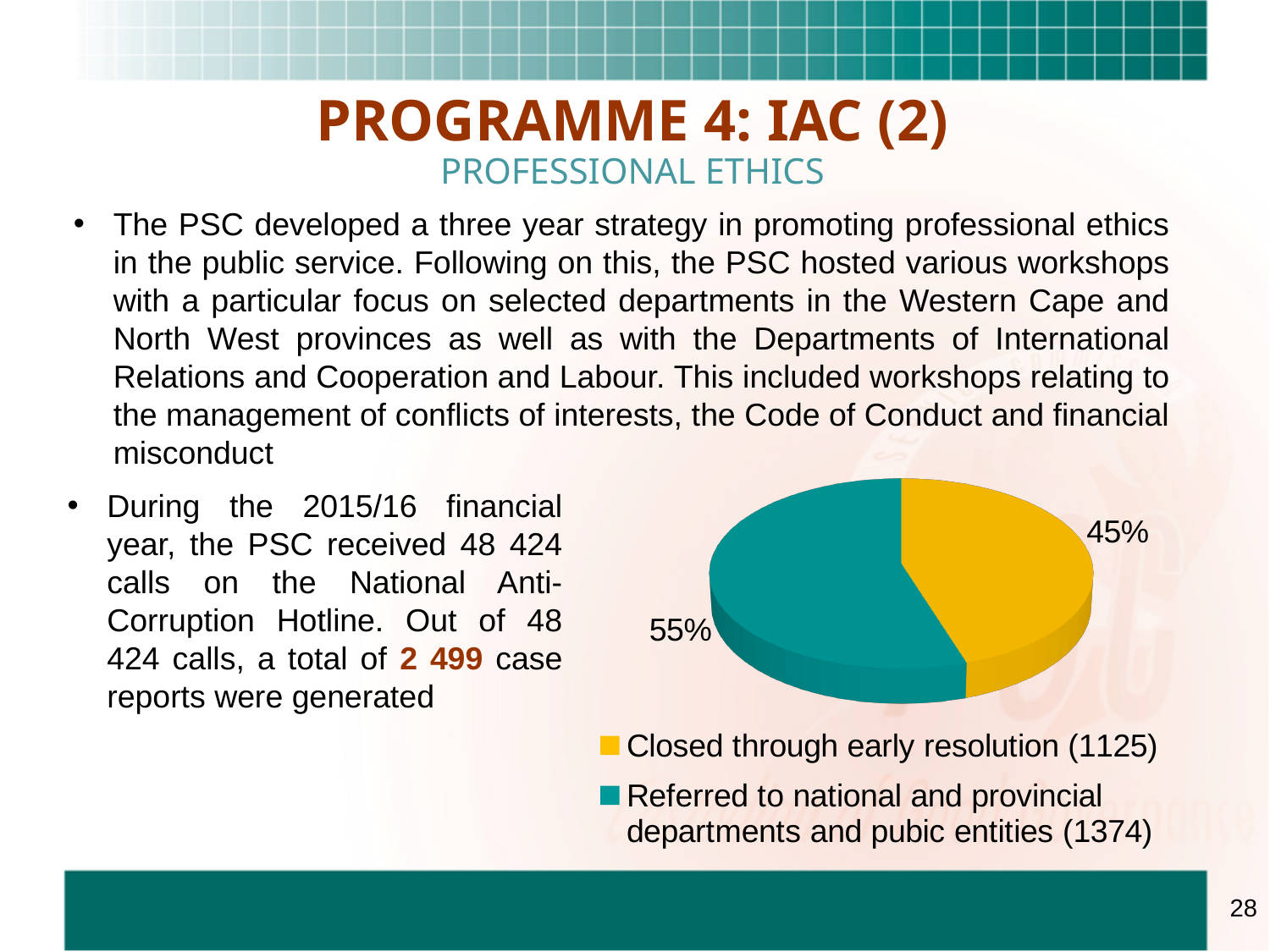
What colour is the 'Referred to national and provincial departments and pubic entities' slice? teal Which is larger: the share closed through early resolution or the share referred to national and provincial departments and public entities? Referred to national and provincial departments and pubic entities How many entries does the legend list? 2 What kind of chart is shown on the slide? pie chart How many slices does the pie chart have? 2 Which slice of the pie is the largest? Referred to national and provincial departments and pubic entities What colour is the 'Closed through early resolution' slice? yellow What is the difference in percentage points between the two slices of the pie? 10 What percentage of the pie is 'Referred to national and provincial departments and pubic entities'? 55% Is the share for 'Closed through early resolution' greater or less than 50%? less Which slice of the pie is the smallest? Closed through early resolution What percentage of the pie is 'Closed through early resolution'? 45%